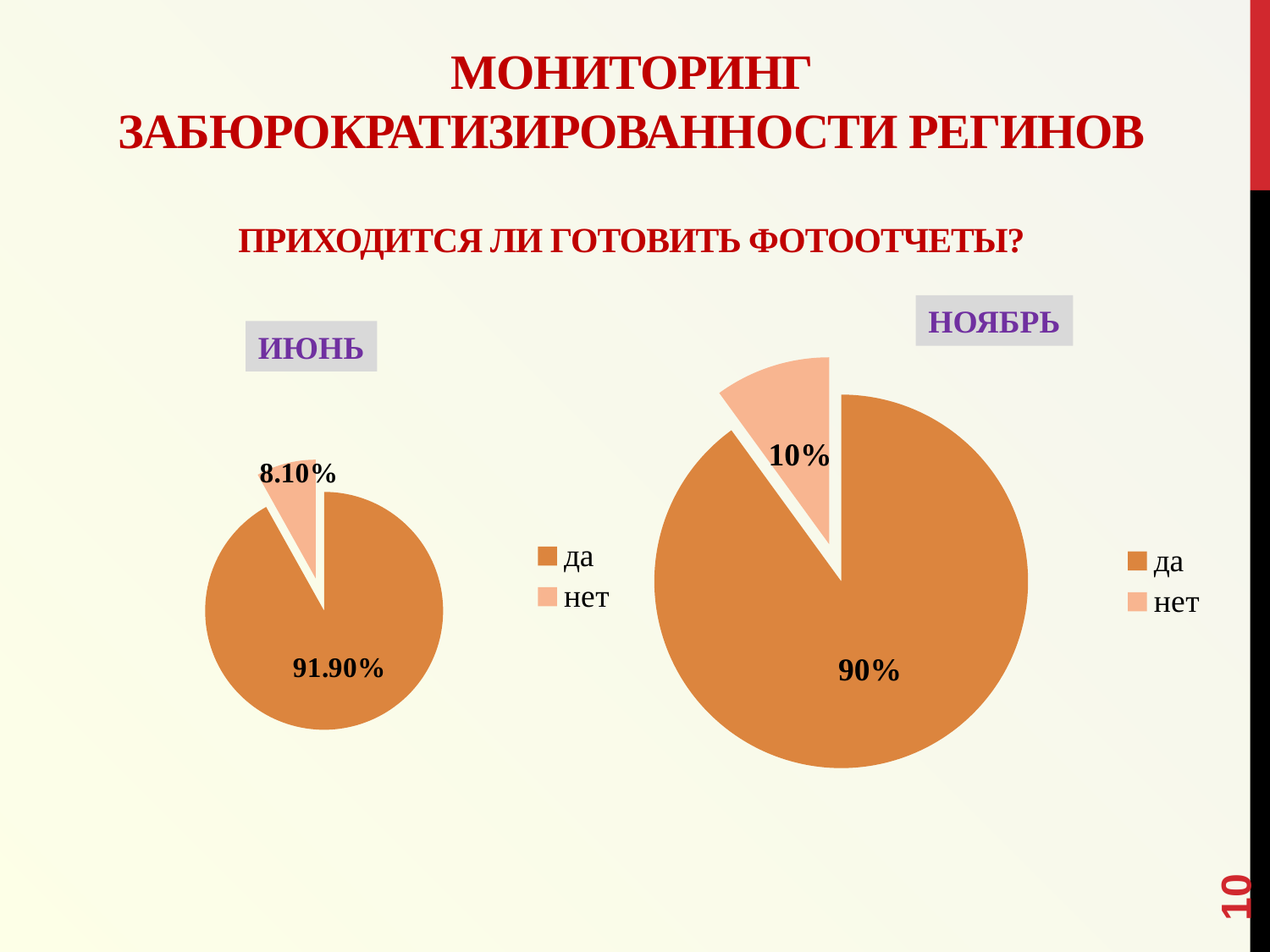
What is the difference between the "да" share in the ИЮНЬ chart and the "да" share in the НОЯБРЬ chart? 1.90% In the НОЯБРЬ pie chart, what share is labelled for "нет"? 10% Which is larger: the "нет" share in the ИЮНЬ chart or the "нет" share in the НОЯБРЬ chart? НОЯБРЬ In the ИЮНЬ pie chart, what share is labelled for "нет"? 8.10% In the НОЯБРЬ pie chart, what colour is the "нет" slice? light peach In the НОЯБРЬ pie chart, what share is labelled for "да"? 90% How many slices does the НОЯБРЬ pie chart have? 2 What kind of chart is used for ИЮНЬ? pie chart In the НОЯБРЬ pie chart, which category has the smallest slice? нет How many entries does the legend of the ИЮНЬ pie chart list? 2 In the ИЮНЬ pie chart, what share is labelled for "да"? 91.90% In the ИЮНЬ pie chart, which category has the largest slice? да